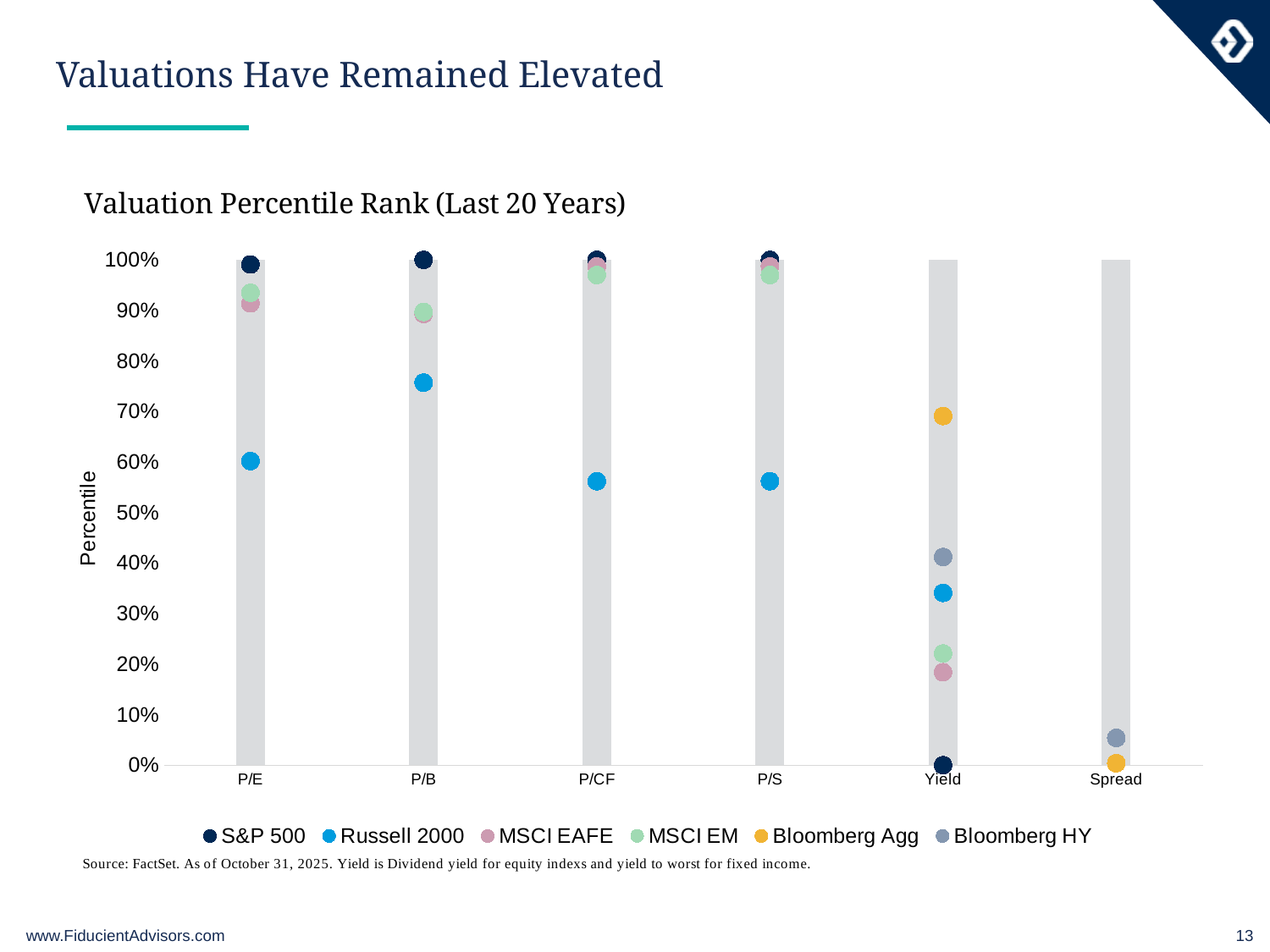
Is the value for Bloomberg Agg at Yield greater or less than 60%? greater Which series has the lowest value at Yield? S&P 500 Is the value for Russell 2000 at P/E greater or less than 50%? greater Is the value for Bloomberg HY at Spread greater or less than 10%? less What is the title of the chart? Valuation Percentile Rank (Last 20 Years) At P/E, which is larger: S&P 500 or Russell 2000? S&P 500 At Yield, which is larger: Bloomberg Agg or Bloomberg HY? Bloomberg Agg Which series has the highest value at Yield? Bloomberg Agg How many series does the legend list? 6 How many categories are shown on the x axis? 6